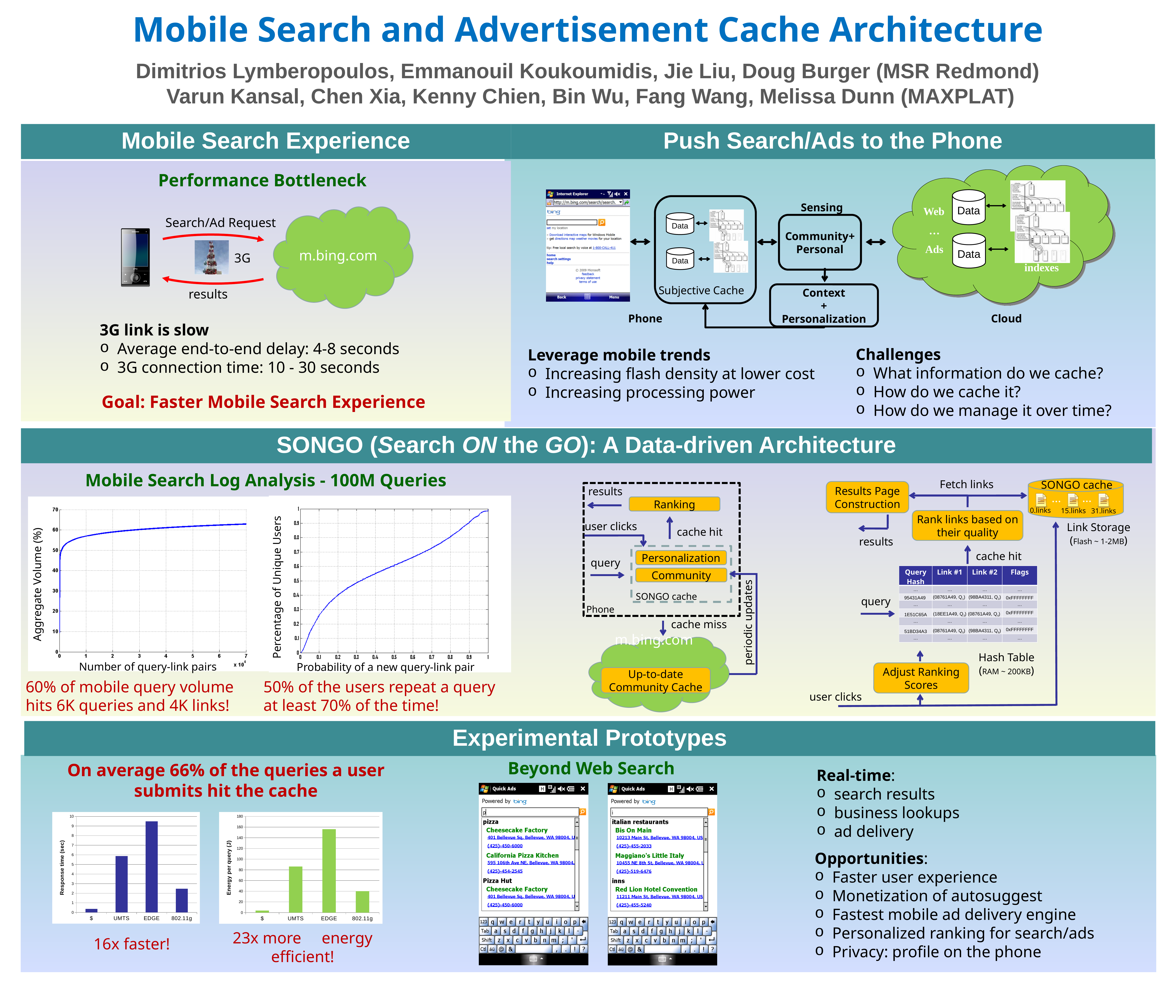
How many categories are shown on the x axis of the Response time (sec) bar chart? 4 In the Response time (sec) bar chart, is the value for EDGE greater or less than 9? greater In the Aggregate Volume (%) line chart under Mobile Search Log Analysis, does the line rise or fall as the number of query-link pairs increases? rise What is the y-axis label of the right-hand line chart under Mobile Search Log Analysis? Percentage of Unique Users In the Response time (sec) bar chart under Experimental Prototypes, which category has the highest response time? EDGE In the Response time (sec) bar chart under Experimental Prototypes, which category has the lowest response time? $ In the Response time (sec) bar chart, which is larger, the value for UMTS or the value for 802.11g? UMTS In the Response time (sec) bar chart, is the value for 802.11g greater or less than 3? less In the Energy per query (J) bar chart, is the value for EDGE greater or less than 140? greater What kind of chart is the Energy per query (J) chart under Experimental Prototypes? bar chart In the Energy per query (J) bar chart under Experimental Prototypes, which category has the highest energy per query? EDGE